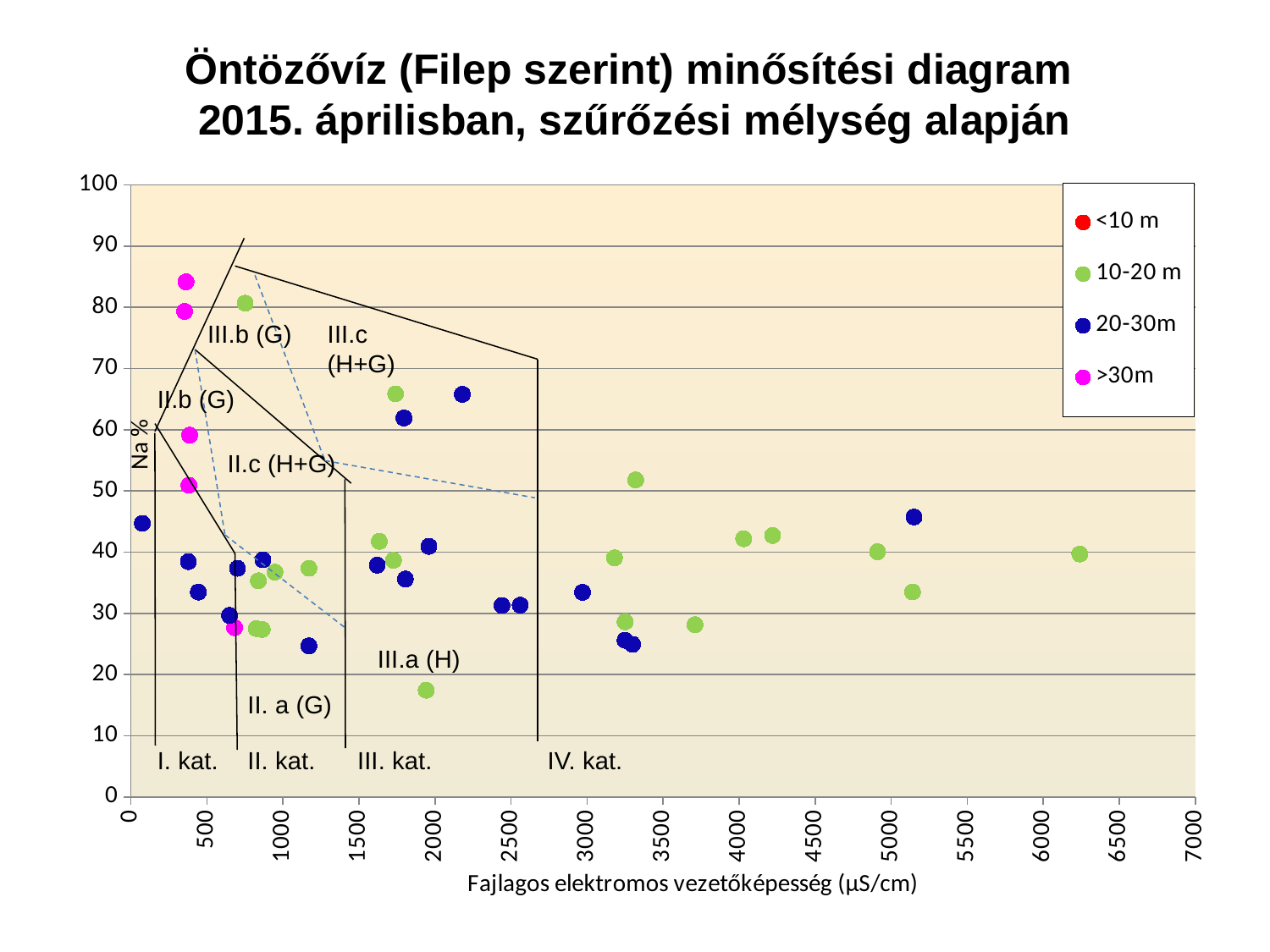
Which series contains the point with the highest conductivity (furthest right)? 10-20 m Is the conductivity of the point with the highest Na % greater or less than 1000? less What is the title of the horizontal axis? Fajlagos elektromos vezetőképesség (µS/cm) Which series contains the point with the highest Na % value? >30m What are the entries listed in the legend? <10 m, 10-20 m, 20-30m, >30m Is the conductivity of the rightmost point greater or less than 6000? greater How many series does the legend list? 4 Is the lowest Na % value plotted greater or less than 20? less What kind of chart is shown on the slide? scatter chart Which series contains the point with the lowest Na % value? 10-20 m